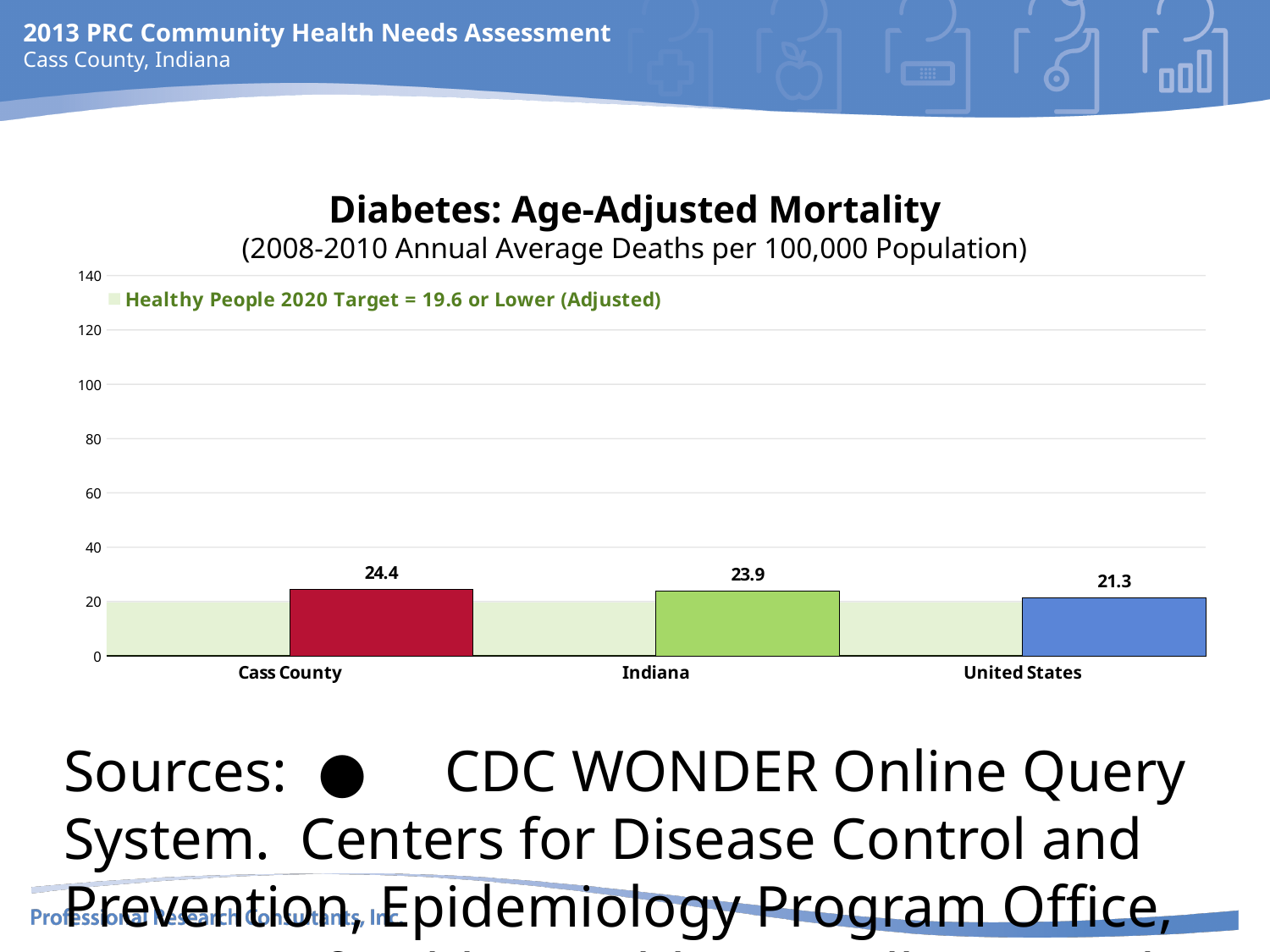
Which category has the lowest value? United States What is the difference between the Cass County value and the United States value? 3.1 Which is larger, the value for Cass County or the value for the United States? Cass County Is the value for Indiana greater or less than 40? less What is the Healthy People 2020 Target shown in the legend? 19.6 or Lower (Adjusted) What is the difference between the Indiana value and the United States value? 2.6 What is the value for Cass County? 24.4 What kind of chart is this? bar chart Which category has the highest value? Cass County How many categories are shown on the x axis? 3 What is the value for Indiana? 23.9 What is the value for the United States? 21.3